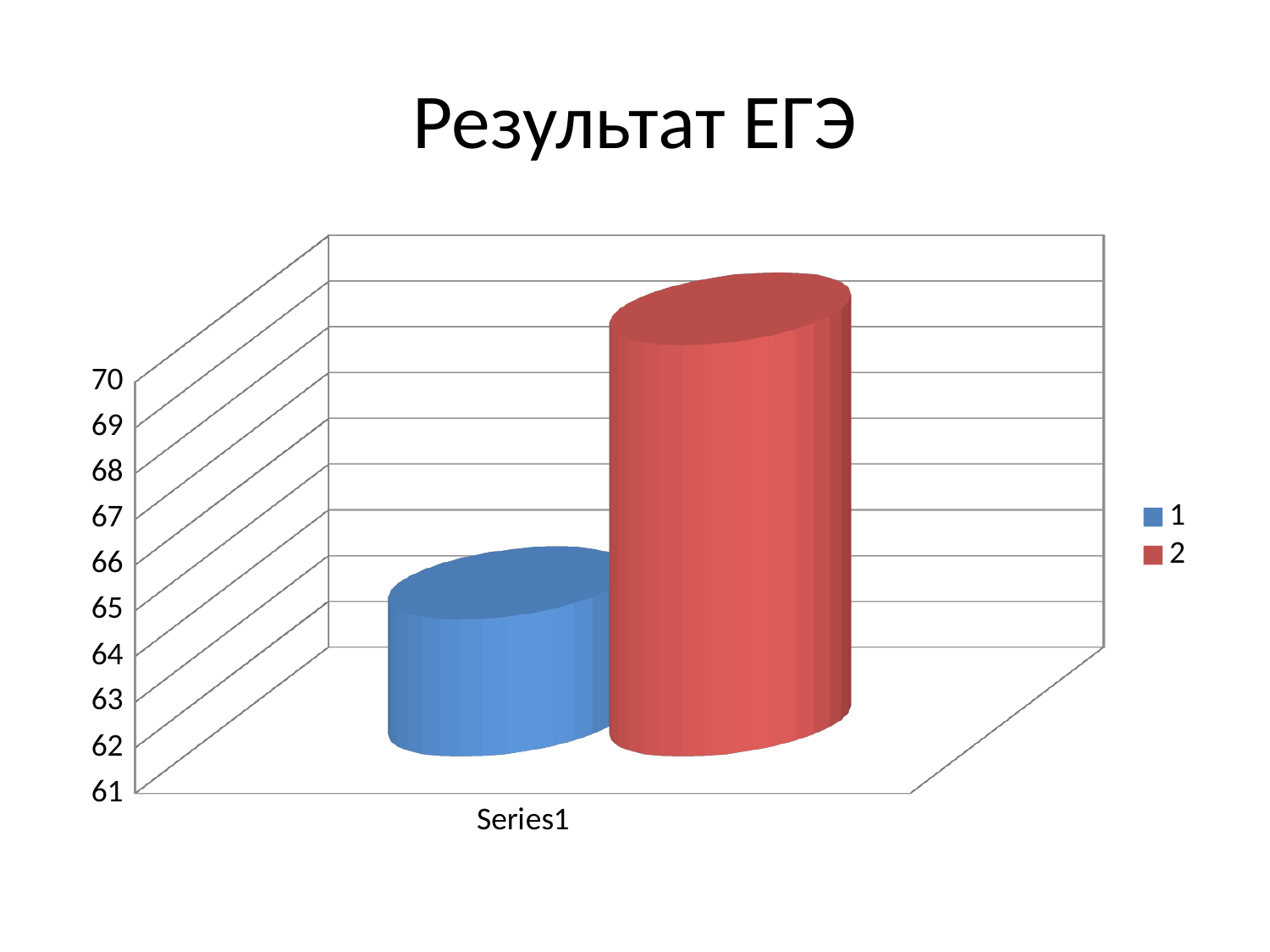
How many categories are shown on the x axis? 1 Is the value for series 1 greater or less than 68? less How many series does the legend list? 2 What is the title of the chart? Результат ЕГЭ What kind of chart is shown on the slide? bar chart Which series has the highest bar? 2 Which series has the lowest bar? 1 What colour is the bar for series 2? red Which series has the higher value for Series1, 1 or 2? 2 What is the label of the category on the x axis? Series1 Is the value for series 2 greater or less than 67? greater